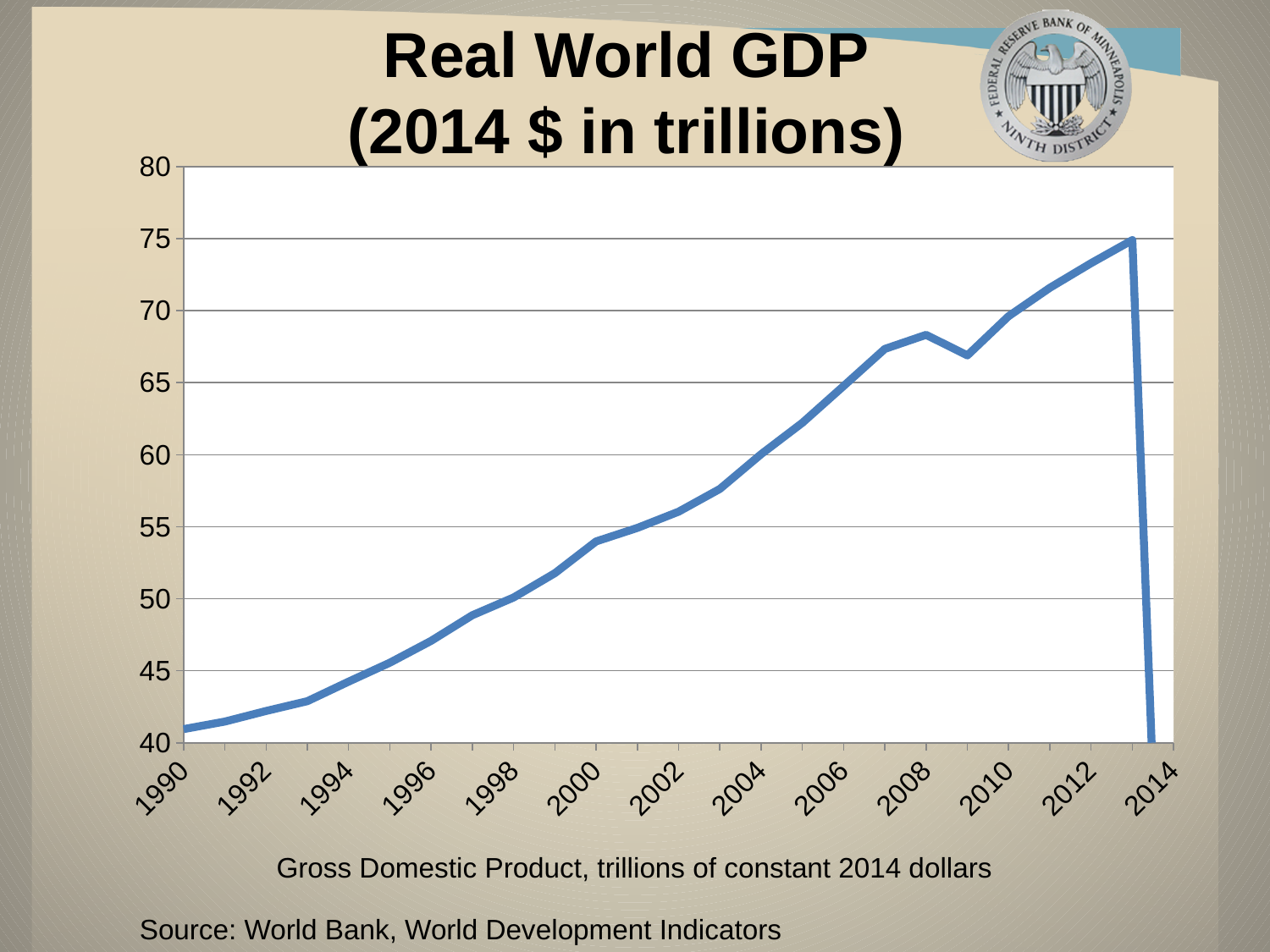
What source is cited for the chart data? World Bank, World Development Indicators Is the value for 2004 greater or less than 55? greater What kind of chart is shown on the slide? Line chart How many year labels are shown on the x axis? 13 In which year does the line reach its highest value? 2013 Is the value for 2008 greater or less than 65? greater Which year has the larger value, 2008 or 2009? 2008 Is the value for 1990 greater or less than 45? less Does real world GDP generally rise or fall between 1990 and 2013? Rise What is the title of the chart? Real World GDP (2014 $ in trillions)